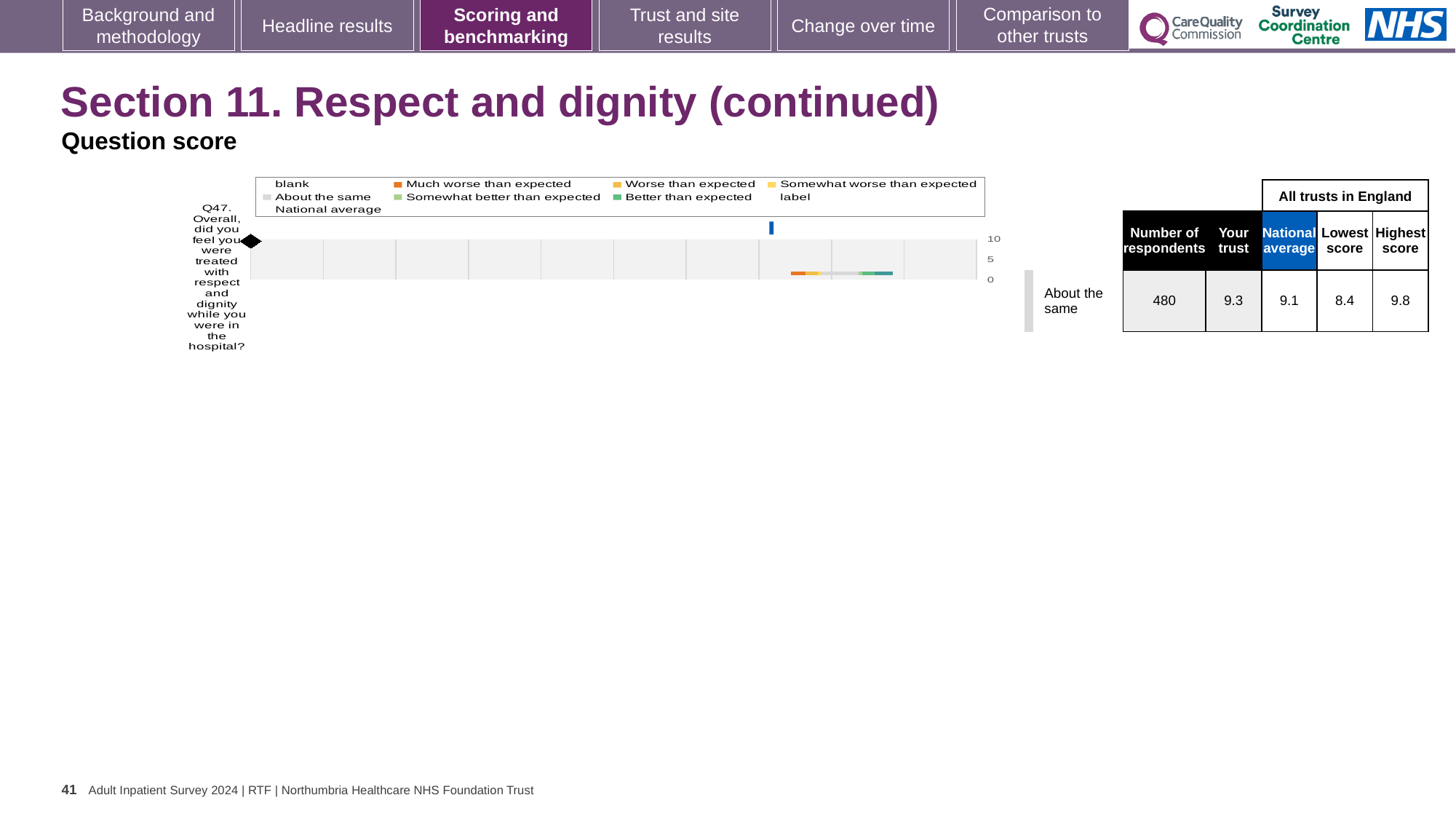
What is the difference between the highest score and the lowest score for Q47 in the table beside the chart? 1.4 What benchmarking category is the trust's Q47 score placed in? About the same In the table beside the chart, what is the 'Your trust' score for Q47? 9.3 What is the highest tick value shown on the chart's vertical axis? 10 Which is larger for Q47, the 'Your trust' score or the national average? Your trust In the table beside the chart, what is the national average score for Q47? 9.1 In the table beside the chart, what is the lowest score among all trusts in England for Q47? 8.4 Which question is plotted on the chart? Q47. Overall, did you feel you were treated with respect and dignity while you were in the hospital? How many questions are plotted on the chart? 1 In the table beside the chart, what is the number of respondents for Q47? 480 In the table beside the chart, what is the highest score among all trusts in England for Q47? 9.8